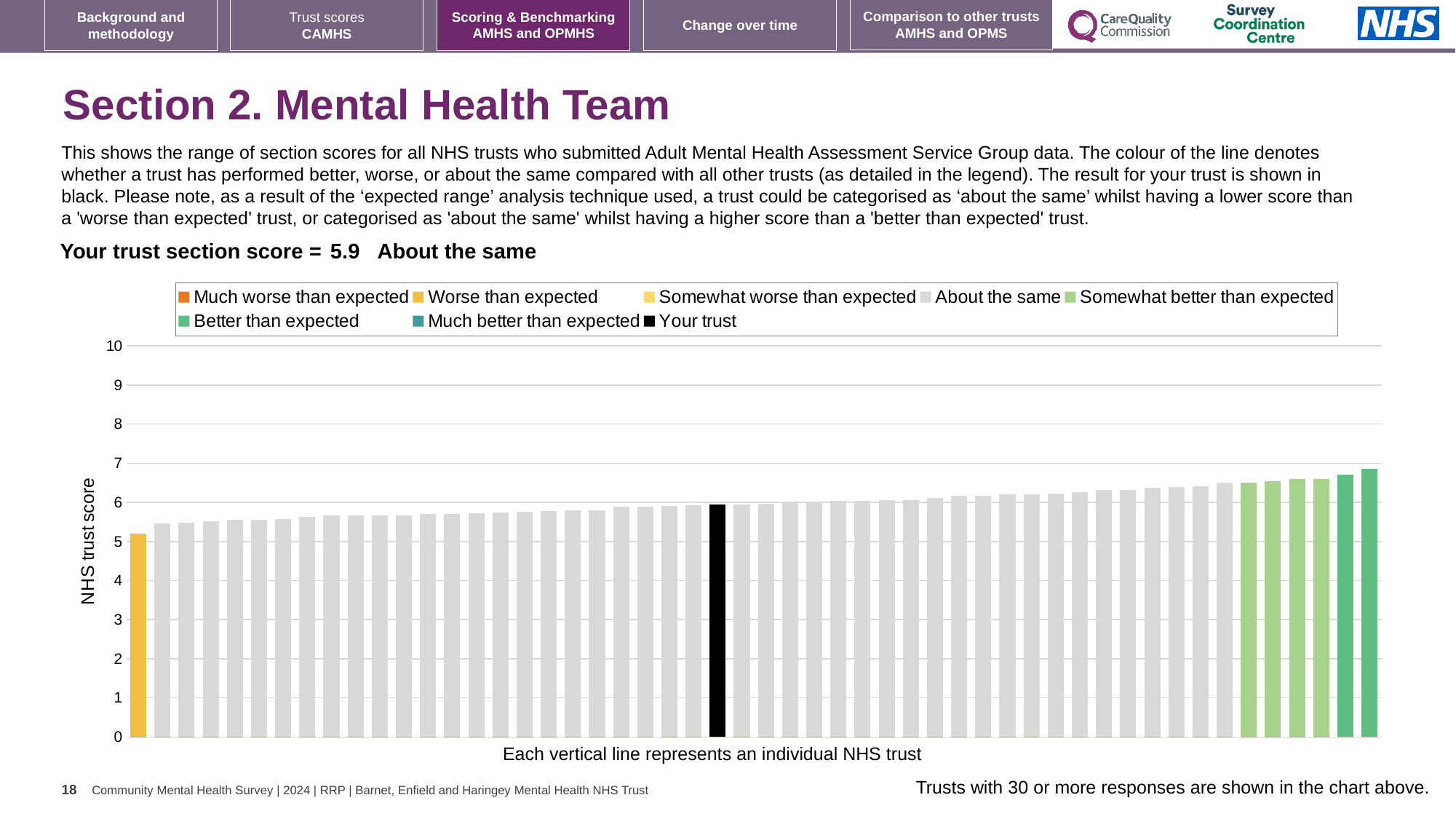
What is the label on the vertical axis of the chart? NHS trust score Is the value of the black 'Your trust' bar greater or less than 5? greater How many bars in the chart are coloured as 'Worse than expected'? 1 How many entries does the chart legend list? 8 Which is taller, the leftmost bar or the rightmost bar? the rightmost bar Is the value of the shortest bar in the chart greater or less than 6? less Is the value of the tallest bar in the chart greater or less than 7? less Do the bar values rise or fall from left to right across the chart? rise What kind of chart is shown on the slide? bar chart What colour is used for the 'Your trust' bar in the chart? black What is your trust's section score for Section 2, Mental Health Team? 5.9 Which category is your trust placed in for Section 2, Mental Health Team? About the same